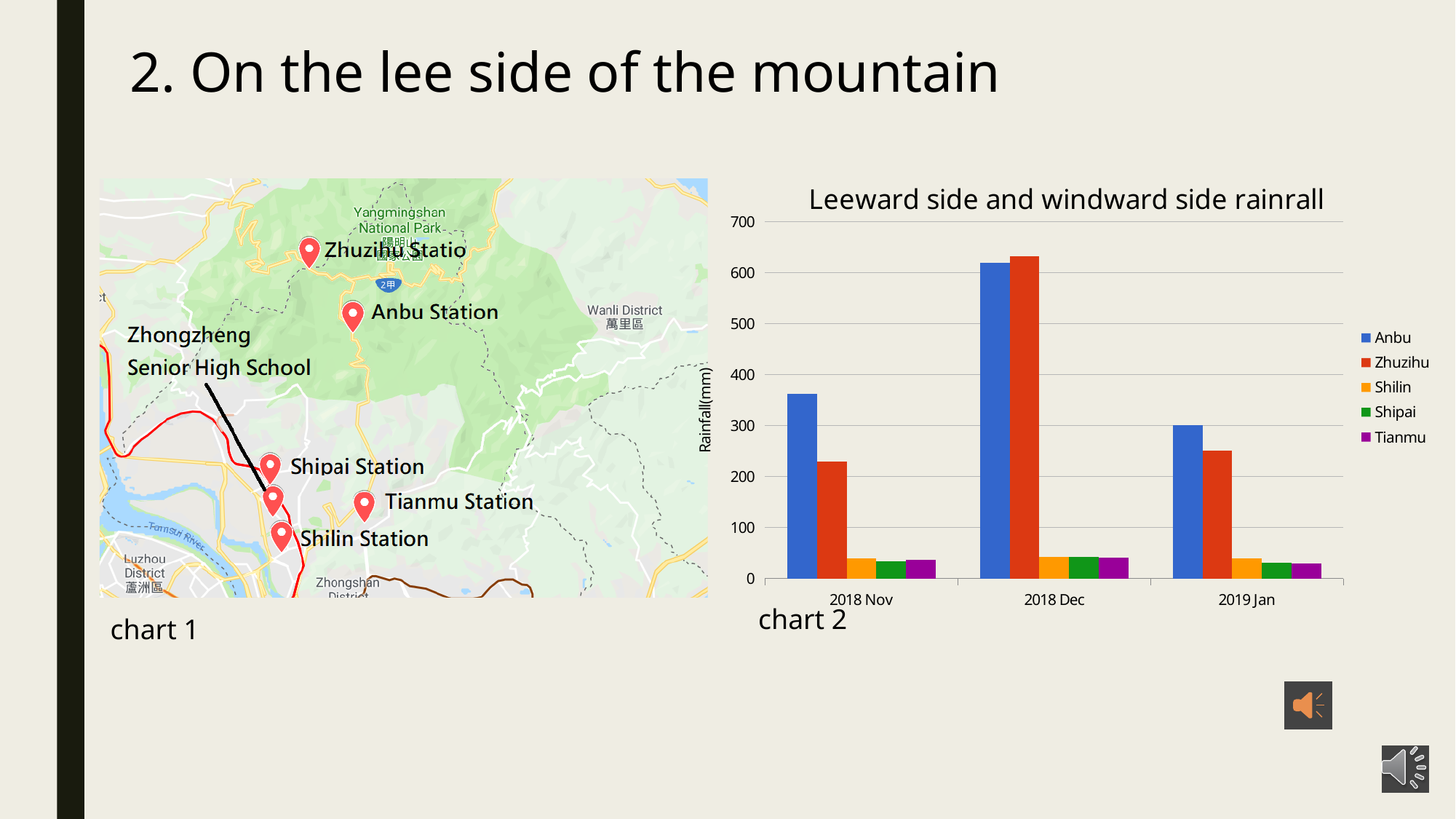
In chart 2, is the rainfall for Zhuzihu in 2018 Nov greater or less than 300? less In chart 2, which station has the highest rainfall in 2018 Nov? Anbu In chart 2, is the rainfall for Shilin in 2018 Dec greater or less than 100? less In chart 2, which is larger in 2019 Jan, the rainfall for Anbu or for Zhuzihu? Anbu What is the title of chart 2? Leeward side and windward side rainrall How many series does the legend of chart 2 list? 5 What kind of chart is chart 2? bar chart How many months are shown on the x axis of chart 2? 3 In chart 2, in which month is the Anbu rainfall highest? 2018 Dec In chart 2, is the rainfall for Zhuzihu in 2019 Jan greater or less than 300? less